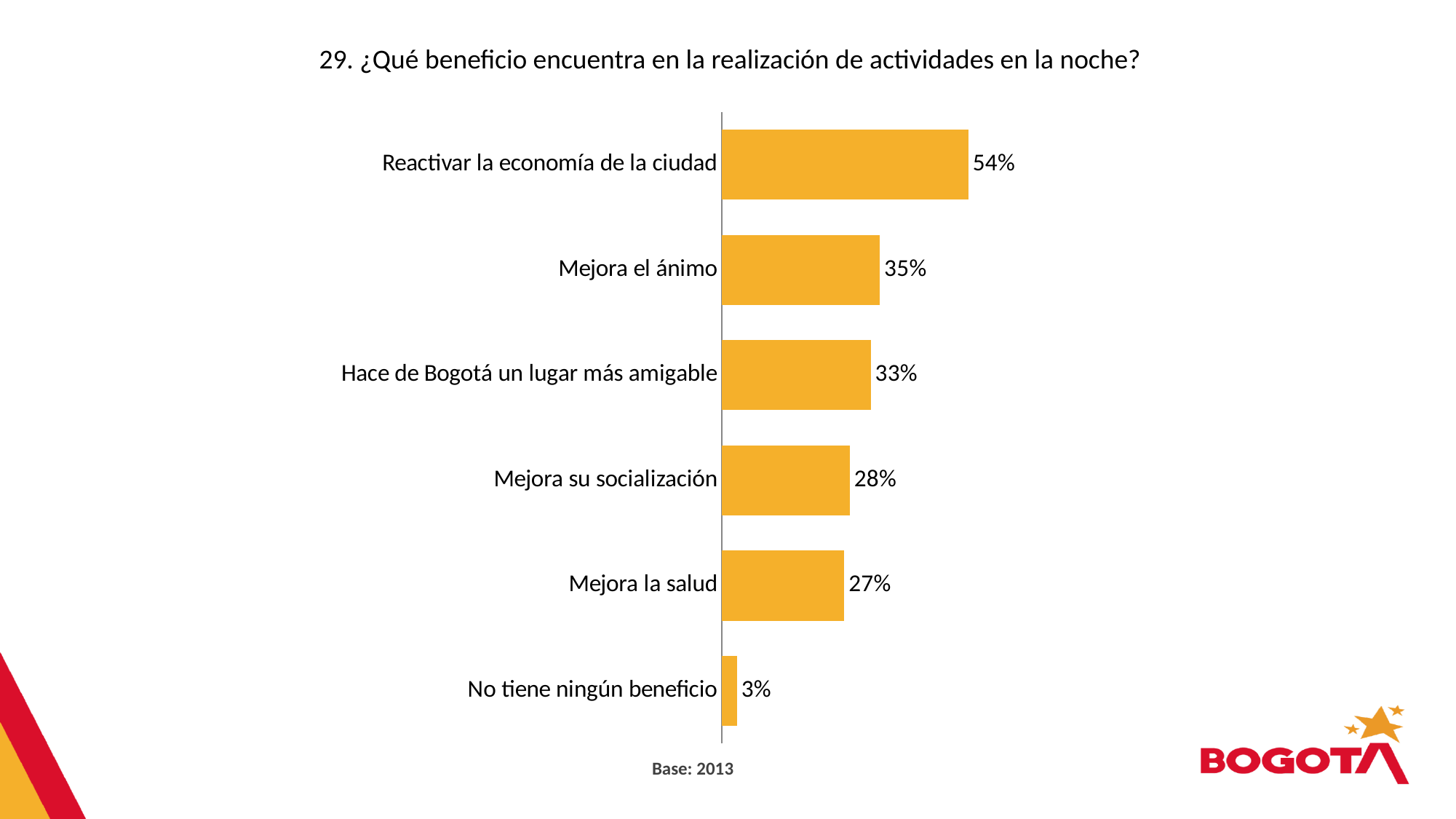
What is the value for "Reactivar la economía de la ciudad"? 54% How many categories are shown in the chart? 6 Which category has the lowest value? No tiene ningún beneficio What base year is noted below the chart? Base: 2013 What is the value for "Mejora la salud"? 27% What is the value for "Mejora el ánimo"? 35% What kind of chart is shown on the slide? Bar chart Which is larger, "Mejora el ánimo" or "Mejora su socialización"? Mejora el ánimo What is the difference between "Mejora su socialización" and "No tiene ningún beneficio"? 25% What is the value for "Hace de Bogotá un lugar más amigable"? 33% Which category has the highest value? Reactivar la economía de la ciudad What is the difference between "Reactivar la economía de la ciudad" and "Mejora el ánimo"? 19%